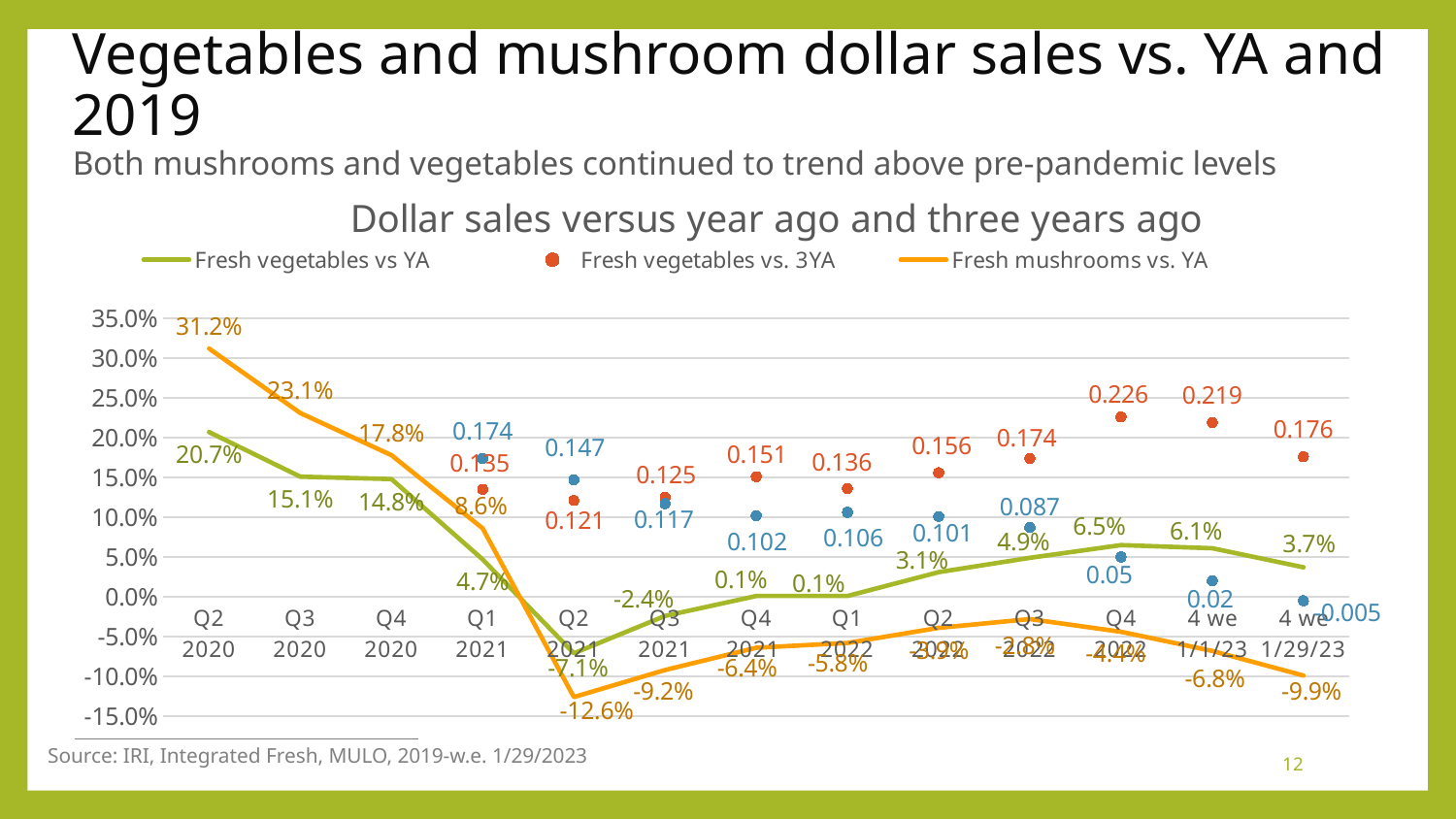
Does Fresh mushrooms vs. YA rise or fall from Q2 2020 to Q2 2021? Fall How many periods are shown on the x axis? 13 How many series does the legend list? 3 In which period is Fresh vegetables vs. 3YA highest? Q4 2022 What is the difference between Fresh vegetables vs YA in Q2 2020 and Q3 2020? 5.6 percentage points In which period is Fresh mushrooms vs. YA highest? Q2 2020 What is the value for Fresh mushrooms vs. YA in Q2 2020? 31.2% What is the value for Fresh vegetables vs YA in Q2 2021? -7.1% In which period is Fresh mushrooms vs. YA lowest? Q2 2021 What kind of chart is shown on the slide? Line chart What is the value for Fresh vegetables vs. 3YA for the 4 weeks ending 1/29/23? 0.176 In Q2 2020, which is larger: Fresh vegetables vs YA or Fresh mushrooms vs. YA? Fresh mushrooms vs. YA